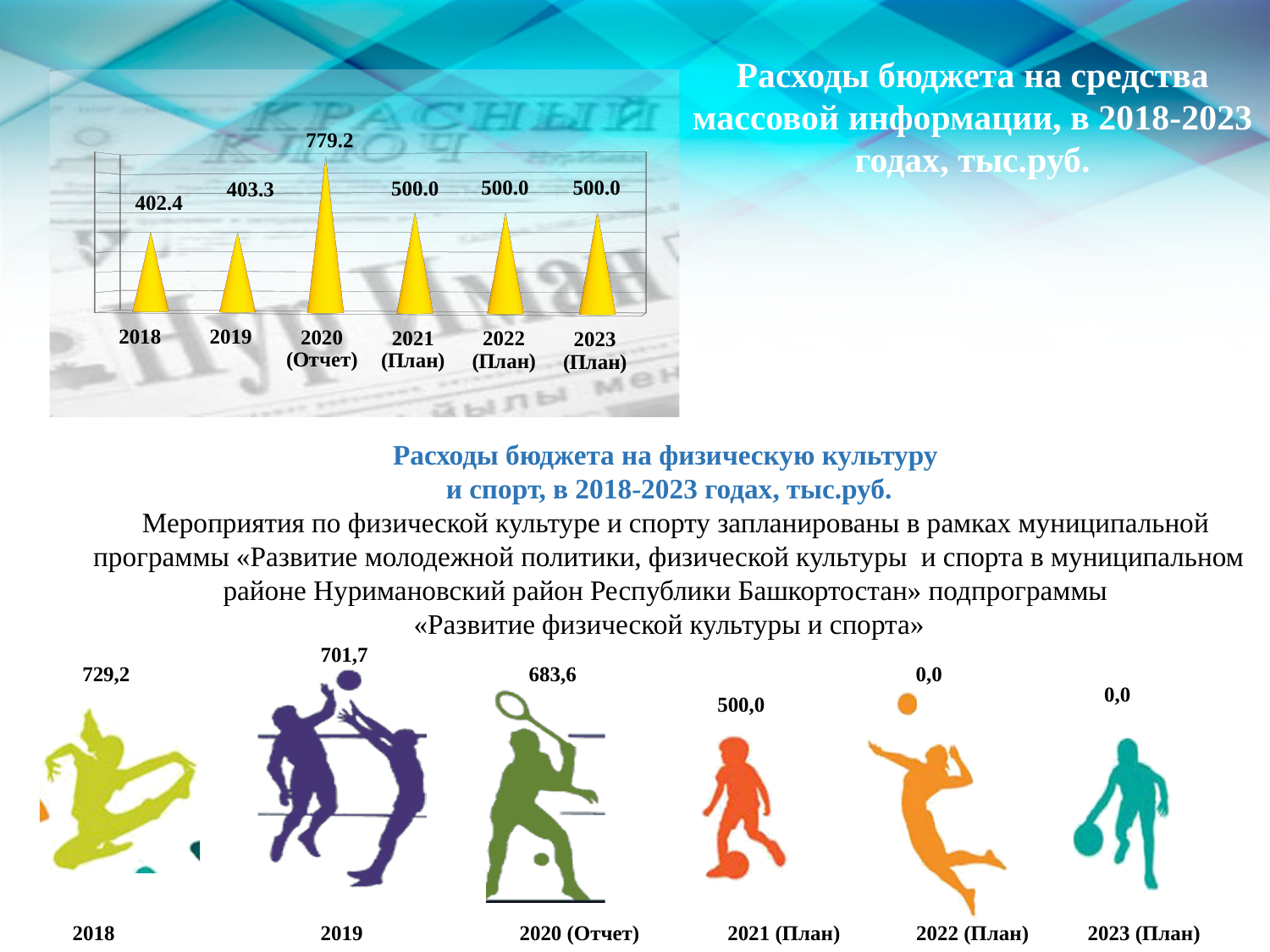
In the bottom infographic on physical culture and sport expenses, which year has the highest value? 2018 What kind of chart is the top-left chart on media expenses? Bar chart In the top-left chart on media expenses, which is larger: the value for 2019 or the value for 2021 (План)? 2021 (План) In the top-left chart on media expenses, which year has the lowest value? 2018 In the top-left chart on media expenses, do the values rise or fall from 2018 to 2020 (Отчет)? Rise In the bottom infographic on physical culture and sport expenses, what is the difference between the values for 2018 and 2019? 27,5 In the top-left chart on media expenses, which year has the highest value? 2020 (Отчет) In the top-left chart on media expenses, what is the difference between the values for 2020 (Отчет) and 2021 (План)? 279.2 How many categories (years) are shown in the top-left chart on media expenses? 6 In the bottom infographic 'Расходы бюджета на физическую культуру и спорт, в 2018-2023 годах, тыс.руб.', what is the value for 2018? 729,2 In the top-left chart on media expenses, what is the value for 2018? 402.4 In the top-left chart 'Расходы бюджета на средства массовой информации, в 2018-2023 годах, тыс.руб.', what is the value for 2020 (Отчет)? 779.2